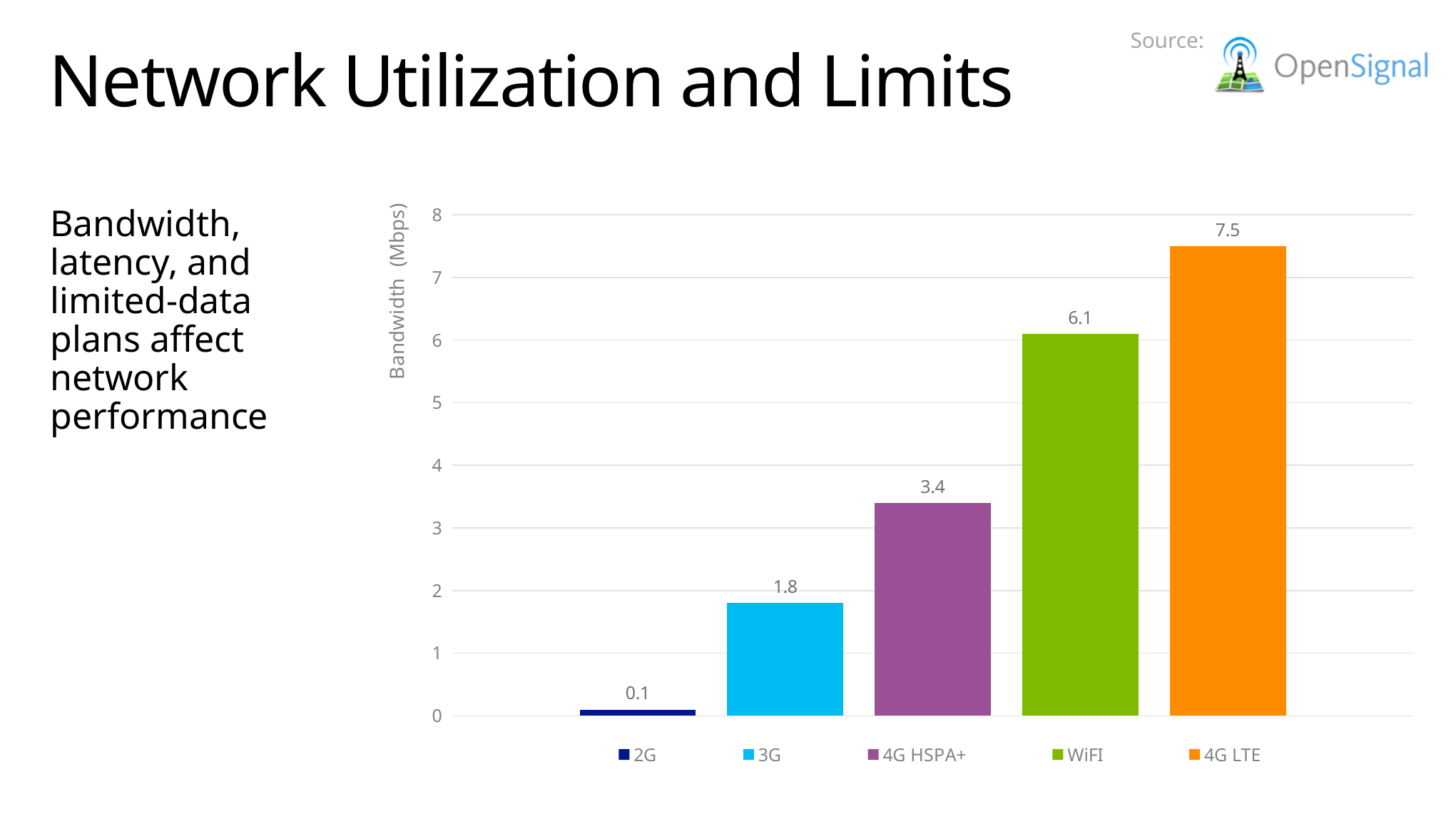
What is the difference in bandwidth between 4G LTE and WiFI? 1.4 What kind of chart is shown on the slide? bar chart Is the value for 4G LTE greater or less than 7? greater Which network type has the highest bandwidth? 4G LTE What is the label of the vertical axis? Bandwidth (Mbps) What is the bandwidth value shown for 4G HSPA+? 3.4 What is the difference in bandwidth between 4G HSPA+ and 3G? 1.6 How many network types are plotted in the chart? 5 Which has a higher bandwidth, WiFI or 4G HSPA+? WiFI Which network type has the lowest bandwidth? 2G What is the bandwidth value shown for 3G? 1.8 What is the bandwidth value shown for WiFI? 6.1